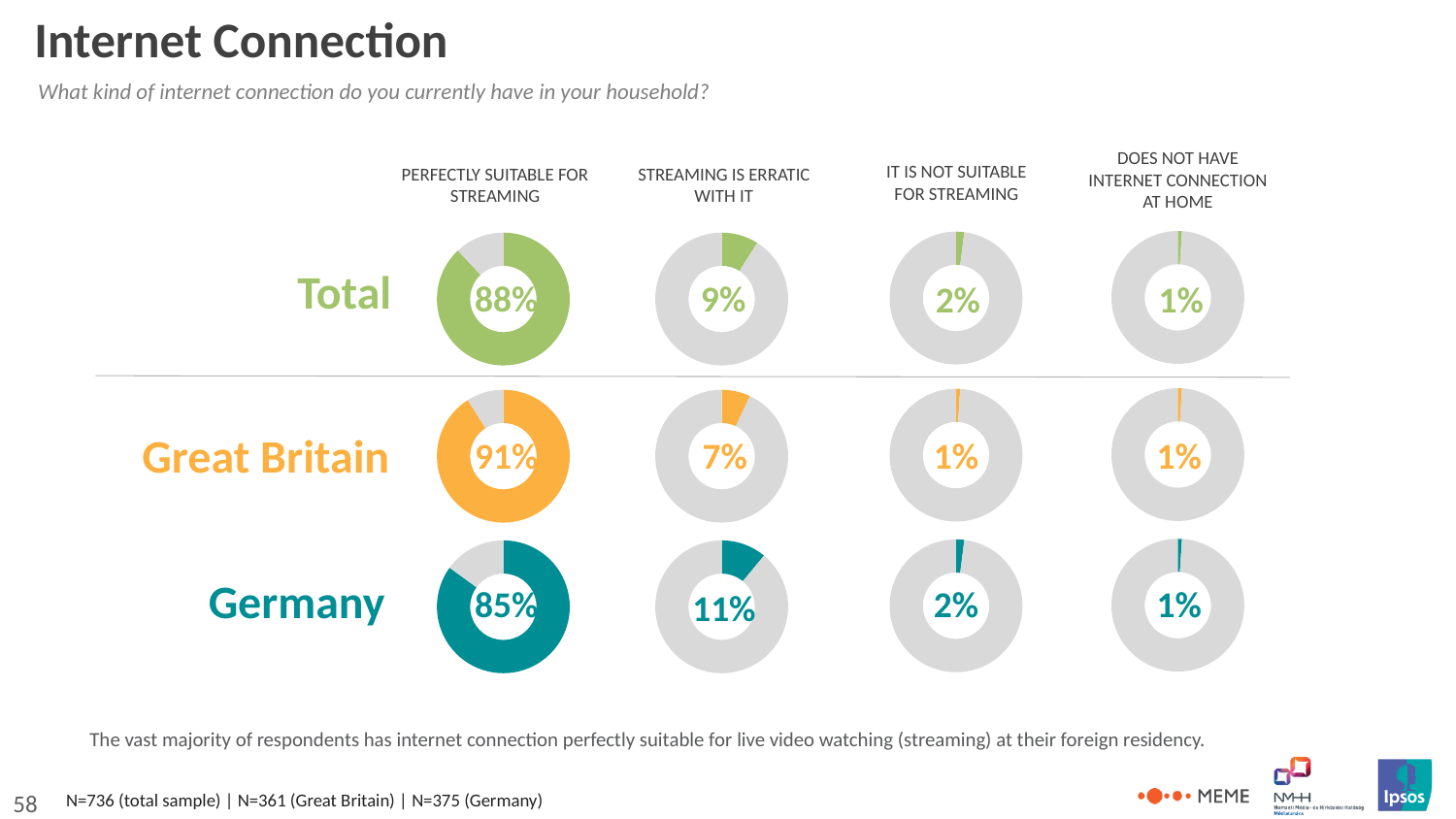
What type of chart is used to show the percentages on this slide? Donut (pie) chart What is the difference between Great Britain and Germany in the share with a connection perfectly suitable for streaming? 6 percentage points In the Germany row, what percentage say their connection is not suitable for streaming? 2% In the Germany row, what percentage say streaming is erratic with their connection? 11% Which row (Total, Great Britain or Germany) has the highest share with a connection perfectly suitable for streaming? Great Britain Is the share saying streaming is erratic higher for Great Britain or for Germany? Germany How many donut charts are shown on the slide? 12 What percentage of respondents in each row do not have an internet connection at home? 1% What colour are the donut charts in the Germany row? Teal In the Great Britain row, what percentage say streaming is erratic with their connection? 7% In the Total row, what percentage of respondents have an internet connection perfectly suitable for streaming? 88% Which row (Total, Great Britain or Germany) has the lowest share with a connection perfectly suitable for streaming? Germany